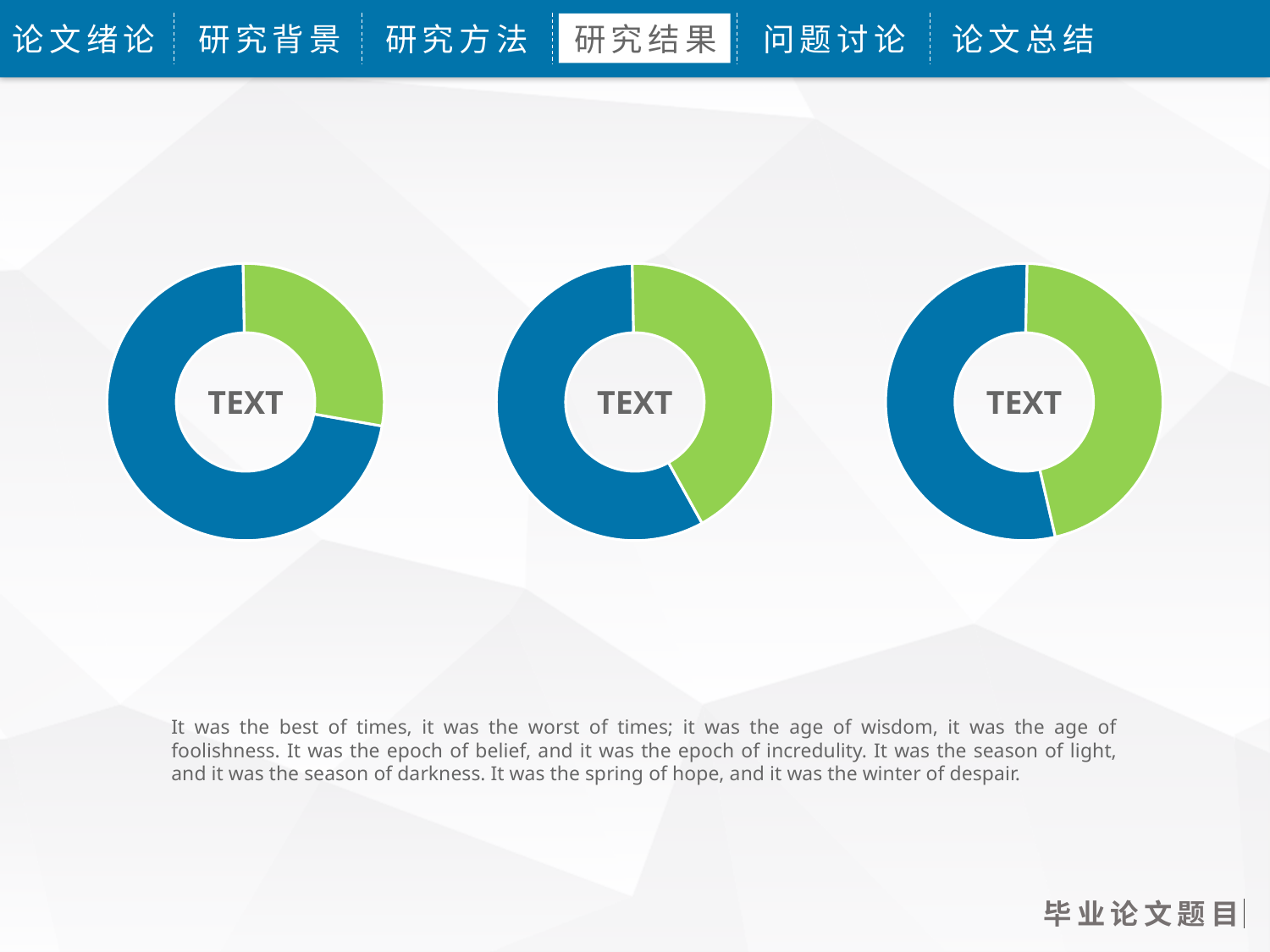
In the middle doughnut chart, which slice is larger, the blue one or the green one? blue In the left doughnut chart, which colour slice is the smallest? green How many slices does the right doughnut chart have? 2 In the left doughnut chart, which colour slice is the largest? blue In the left doughnut chart, which slice is larger, the blue one or the green one? blue How many doughnut charts are shown on the slide? 3 How many slices does the middle doughnut chart have? 2 How many slices does the left doughnut chart have? 2 What kind of chart is the left chart on the slide? doughnut chart In the middle doughnut chart, which colour slice is the smallest? green What text is printed in the centre of each doughnut chart? TEXT